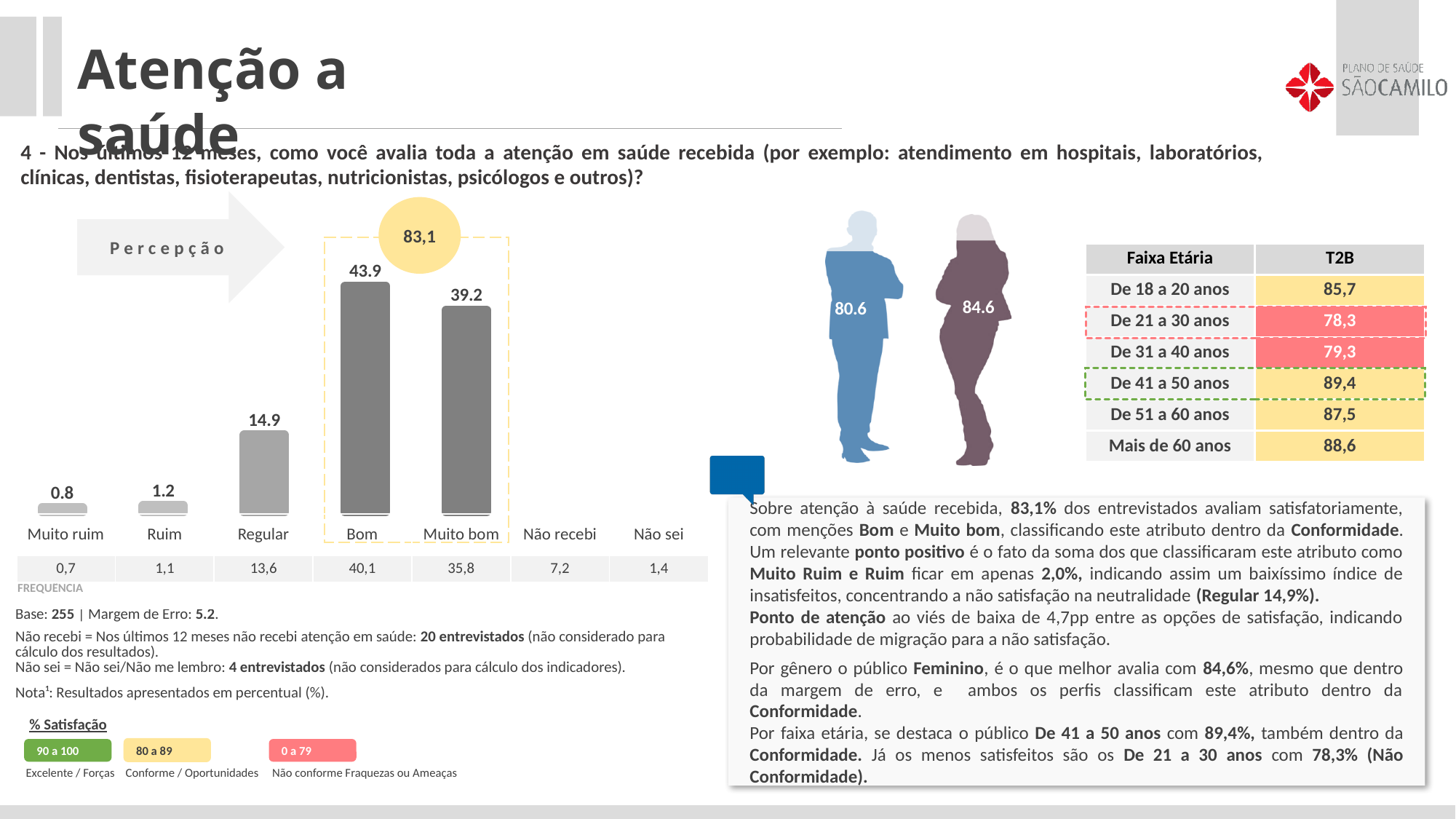
What value is shown in the yellow circle above the 'Bom' and 'Muito bom' bars? 83,1 What is the difference between the 'Bom' and 'Muito bom' values? 4.7 What is the value shown for the 'Ruim' bar? 1.2 Which category has the lowest bar in the chart? Muito ruim What type of chart is shown on the left of the slide? bar chart What is the value shown for the 'Muito ruim' bar? 0.8 What is the difference between the 'Regular' and 'Ruim' values? 13.7 What is the value shown for the 'Bom' bar? 43.9 What is the value shown for the 'Regular' bar? 14.9 Which is larger, the value for 'Regular' or the value for 'Ruim'? Regular What is the value shown for the 'Muito bom' bar? 39.2 Which category has the highest bar in the chart? Bom